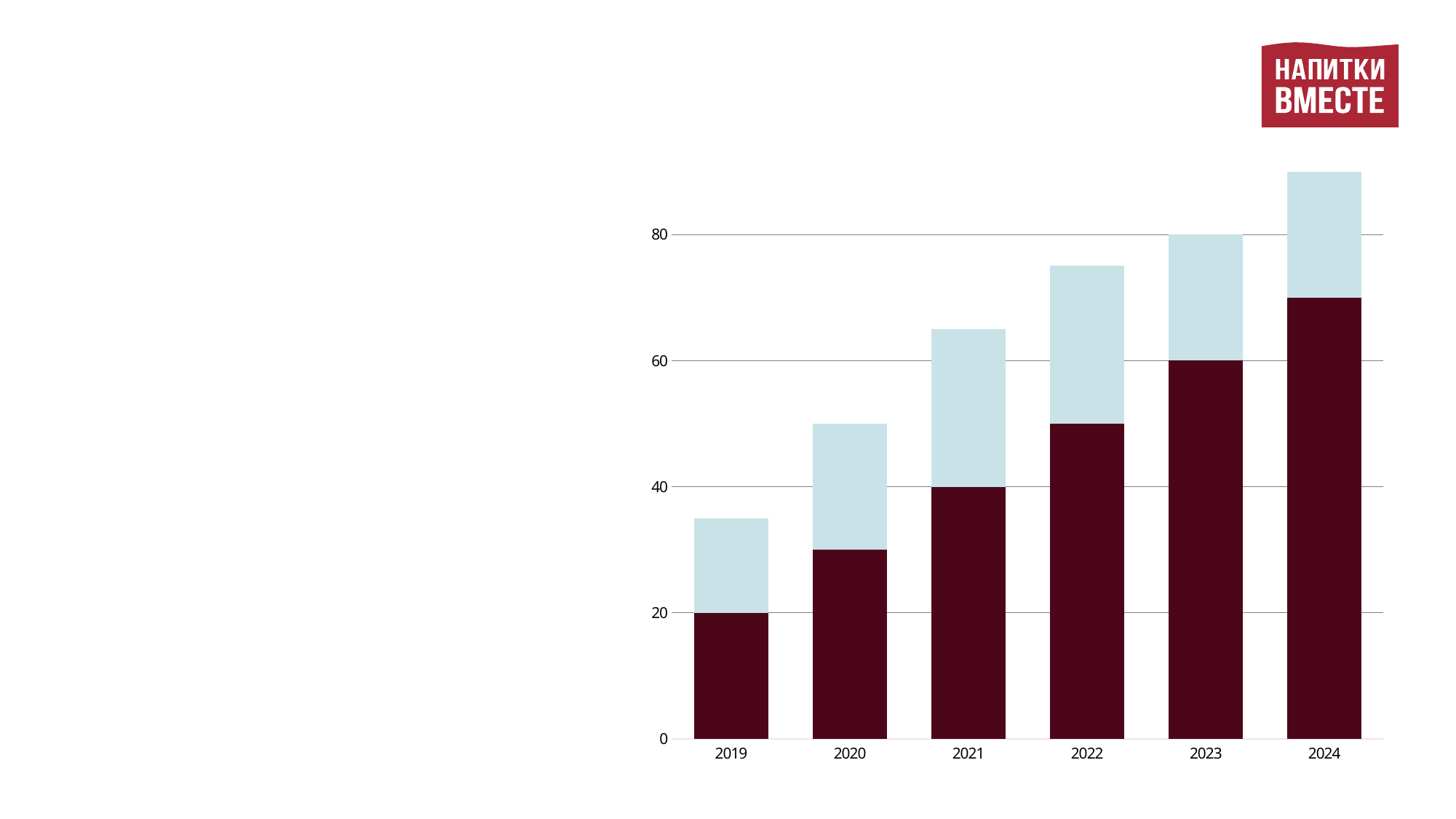
What kind of chart is shown on the slide? stacked bar chart What is the value of the dark (bottom) segment for 2021? 40 What is the value of the dark (bottom) segment for 2019? 20 What is the total height of the stacked bar for 2023? 80 Is the total for 2024 greater or less than 80? greater Which year has the tallest bar in the chart? 2024 How many years are shown on the x axis of the chart? 6 Which year has the shortest bar in the chart? 2019 Is the total for 2019 greater or less than 40? less Do the bar totals rise or fall from 2019 to 2024? rise What is the value of the dark (bottom) segment for 2023? 60 Which is larger, the total bar for 2020 or the total bar for 2022? 2022